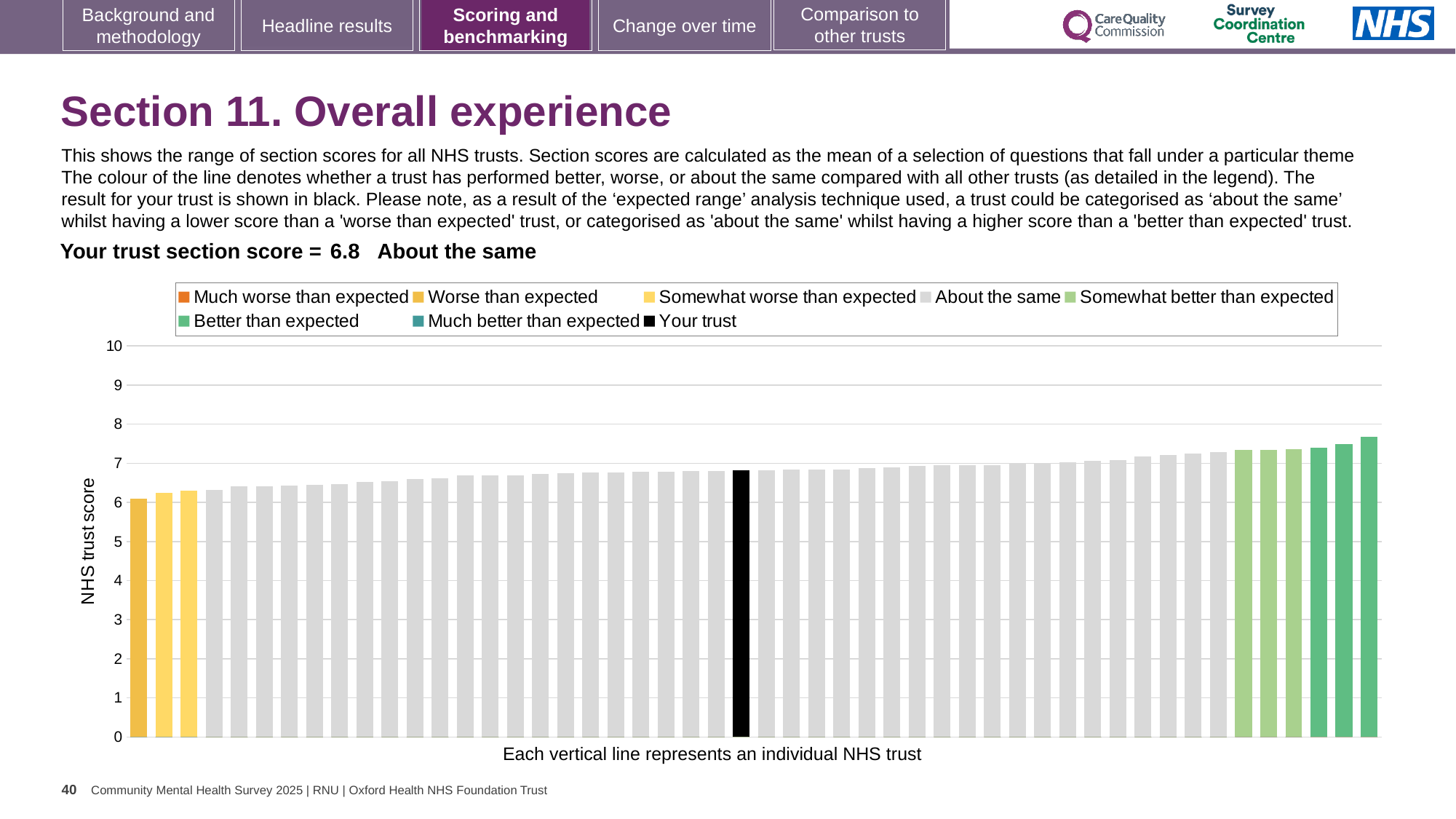
Is the value of the leftmost bar greater or less than 7? less Is the value of the rightmost bar greater or less than 7? greater Do the bar values rise or fall from left to right along the x axis? rise What is the title of the vertical axis? NHS trust score What is the section score for your trust shown on the slide? 6.8 How many bars at the left of the chart are coloured in yellow shades? 3 What colour is the bar representing your trust? black Is the value of the black 'Your trust' bar greater or less than 5? greater How many entries does the chart legend list? 8 Which is larger, the rightmost bar or the black 'Your trust' bar? the rightmost bar What kind of chart is shown on the slide? bar chart Which category is your trust placed in for this section? About the same